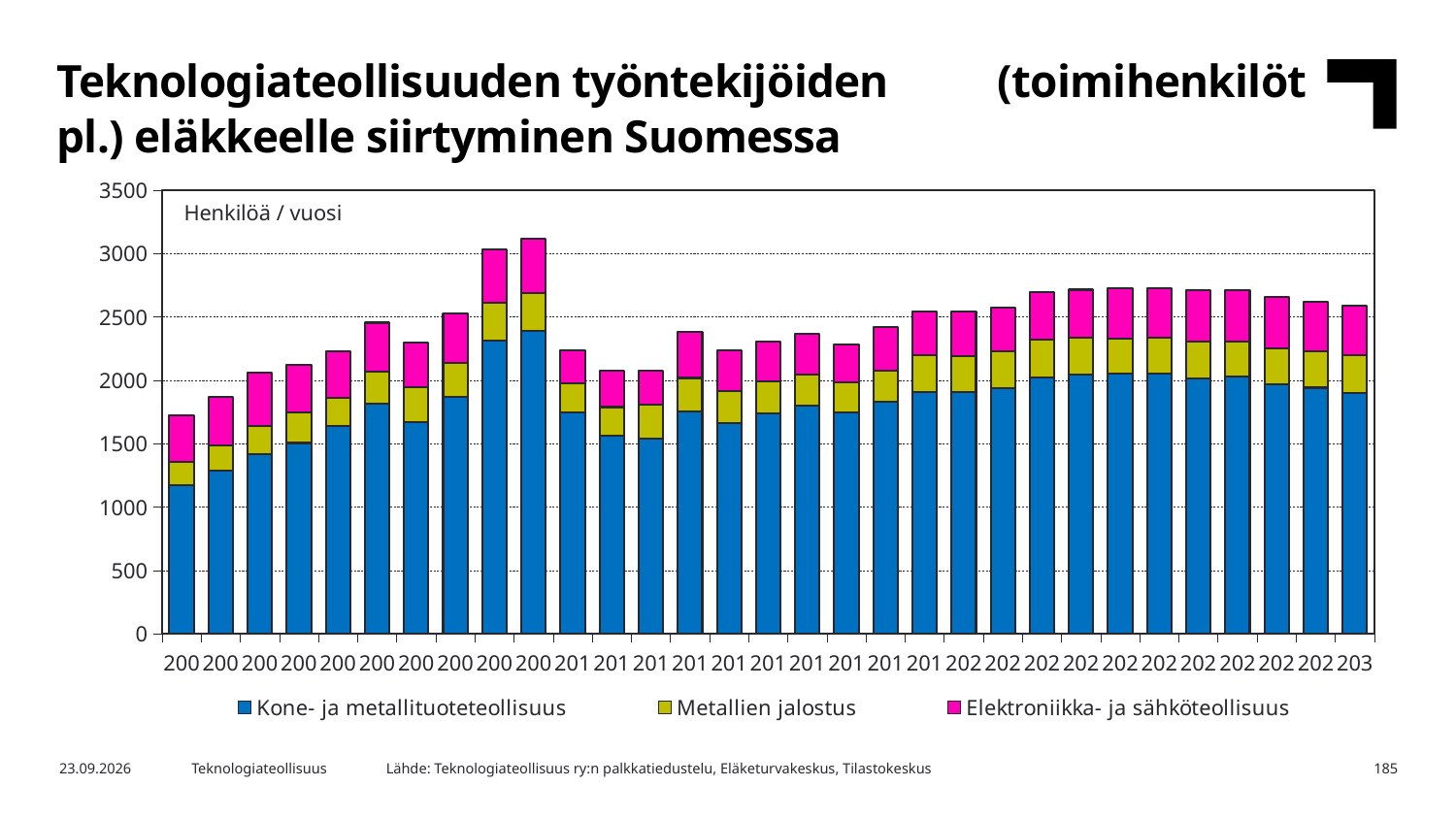
How many bars are plotted in the chart? 31 How many series does the legend list? 3 Which series forms the smallest segment in every bar? Metallien jalostus Which series is shown in blue in the legend? Kone- ja metallituoteteollisuus Which series forms the largest segment in every bar? Kone- ja metallituoteteollisuus Is the Kone- ja metallituoteteollisuus value in the first (leftmost) bar greater or less than 1000? greater What unit label is printed inside the plot area? Henkilöä / vuosi Is the total of the first (leftmost) bar greater or less than 2000? less Is the total of the tallest bar greater or less than 3000? greater What is the maximum value shown on the vertical axis? 3500 What kind of chart is shown on the slide? Stacked bar chart